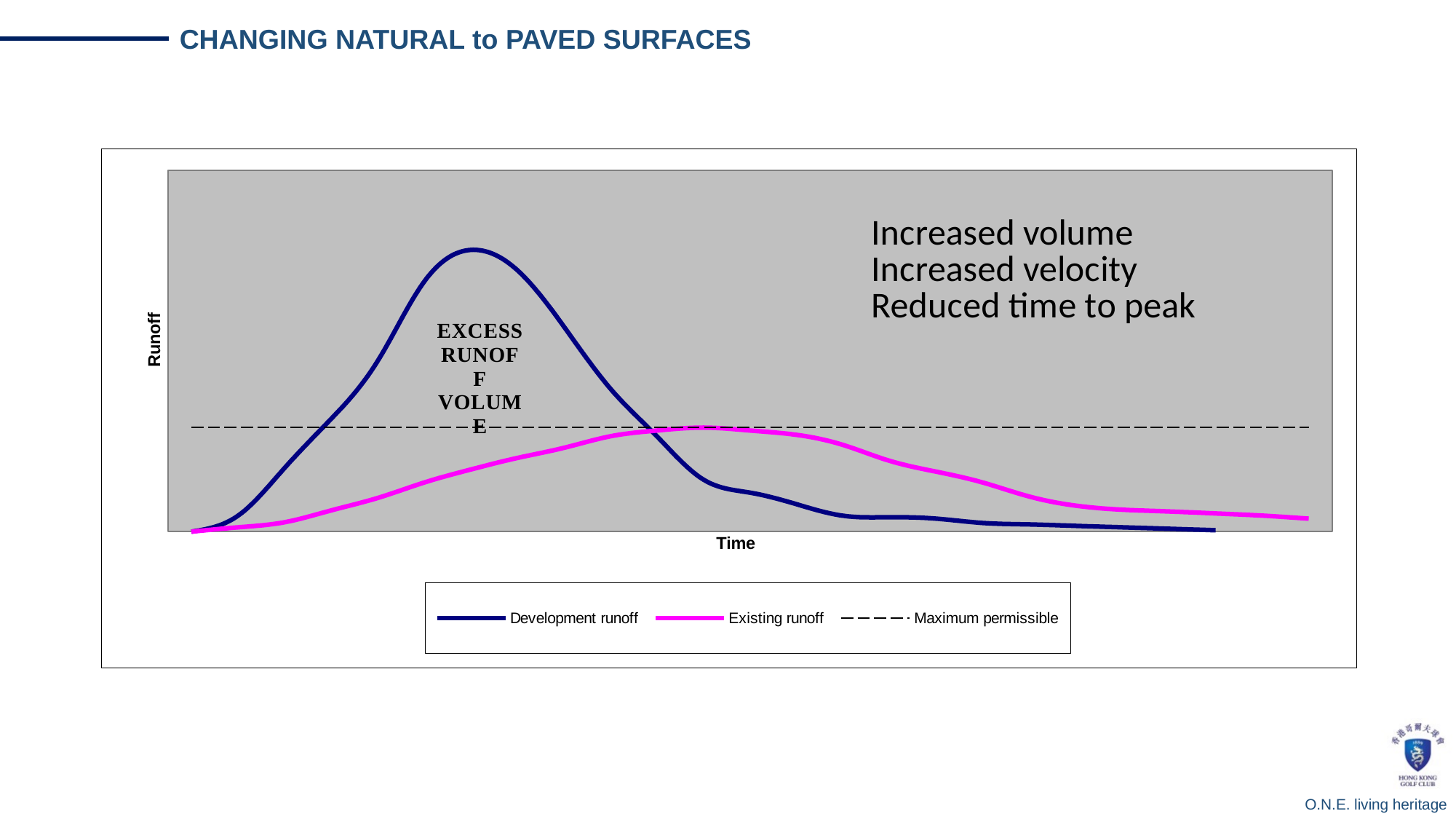
Before its peak, does the Existing runoff line rise or fall as time increases? rise Which series is drawn as a dashed line in the chart? Maximum permissible After reaching its peak, does the Development runoff line rise or fall as time increases? fall What kind of chart is shown on the slide? line chart How many series does the chart legend list? 3 What is the label on the x axis of the chart? Time Does the peak of the Development runoff line lie above or below the Maximum permissible line? above Which series reaches the higher peak, Development runoff or Existing runoff? Development runoff Which series reaches its peak earlier in time, Development runoff or Existing runoff? Development runoff